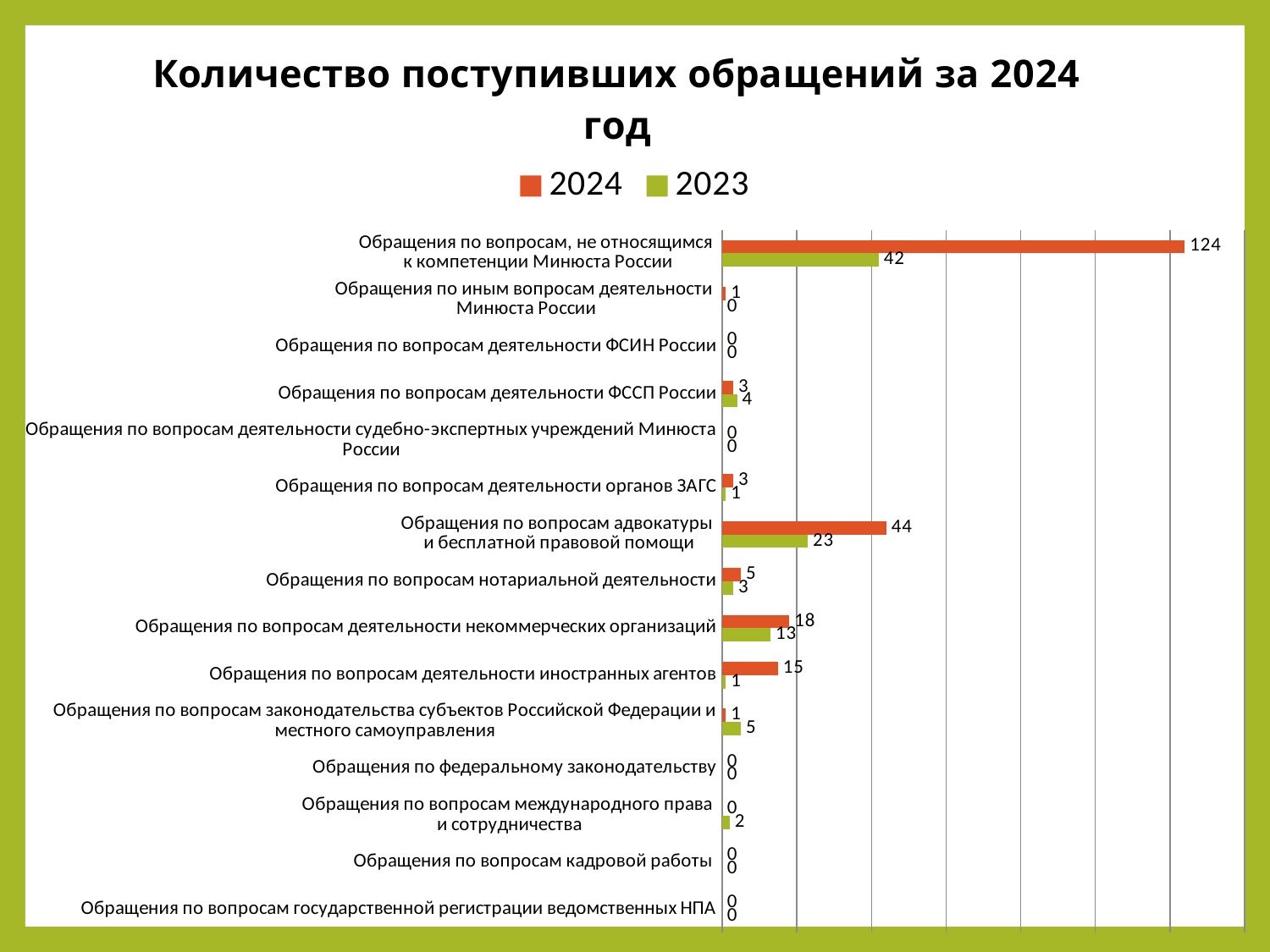
What is the difference between the 2024 and 2023 values for 'Обращения по вопросам адвокатуры и бесплатной правовой помощи'? 21 What is the 2023 value for 'Обращения по вопросам законодательства субъектов Российской Федерации и местного самоуправления'? 5 How many categories are shown on the chart? 15 What is the 2023 value for 'Обращения по вопросам адвокатуры и бесплатной правовой помощи'? 23 For 'Обращения по вопросам деятельности ФССП России', which year has the larger value, 2024 or 2023? 2023 What is the 2024 value for 'Обращения по вопросам деятельности иностранных агентов'? 15 Which category has the highest 2024 value? Обращения по вопросам, не относящимся к компетенции Минюста России What is the 2024 value for 'Обращения по вопросам, не относящимся к компетенции Минюста России'? 124 What type of chart is shown on the slide? bar chart What is the title of the chart? Количество поступивших обращений за 2024 год What is the difference between the 2024 and 2023 values for 'Обращения по вопросам деятельности некоммерческих организаций'? 5 How many series does the legend list? 2